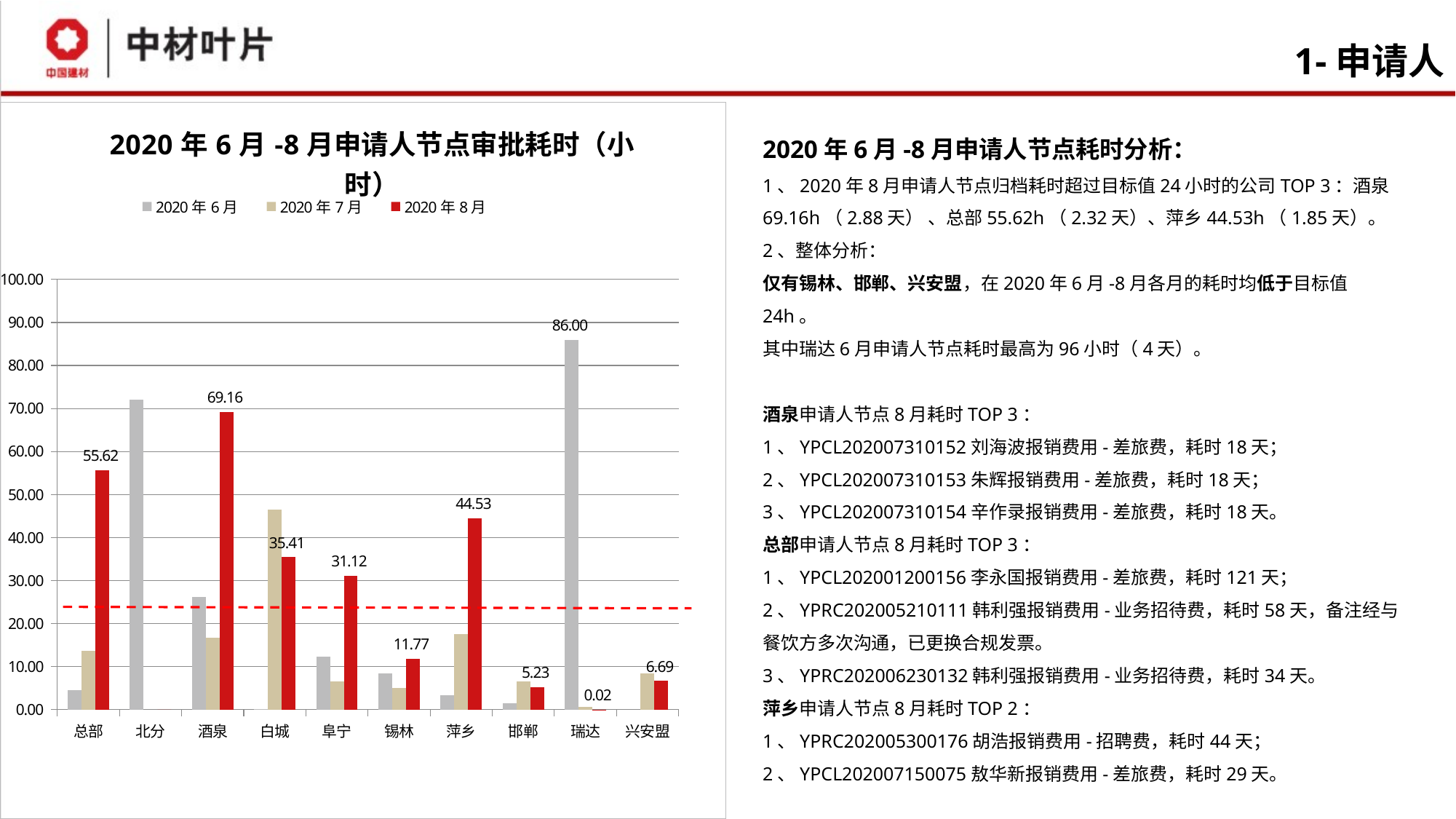
Which category has the highest 2020年8月 value? 酒泉 Is the 2020年6月 value for 瑞达 greater or less than 80? greater What kind of chart is shown on the slide? bar chart Which category has the lowest labelled 2020年8月 value? 瑞达 What is the 2020年8月 value for 酒泉? 69.16 What is the difference between the 2020年8月 values for 酒泉 and 总部? 13.54 What colour are the 2020年8月 bars in the chart? red Which has the larger 2020年8月 value, 萍乡 or 白城? 萍乡 How many series does the chart legend list? 3 What is the 2020年8月 value for 总部? 55.62 How many categories are shown along the x axis of the chart? 10 What is the 2020年8月 value for 瑞达? 0.02